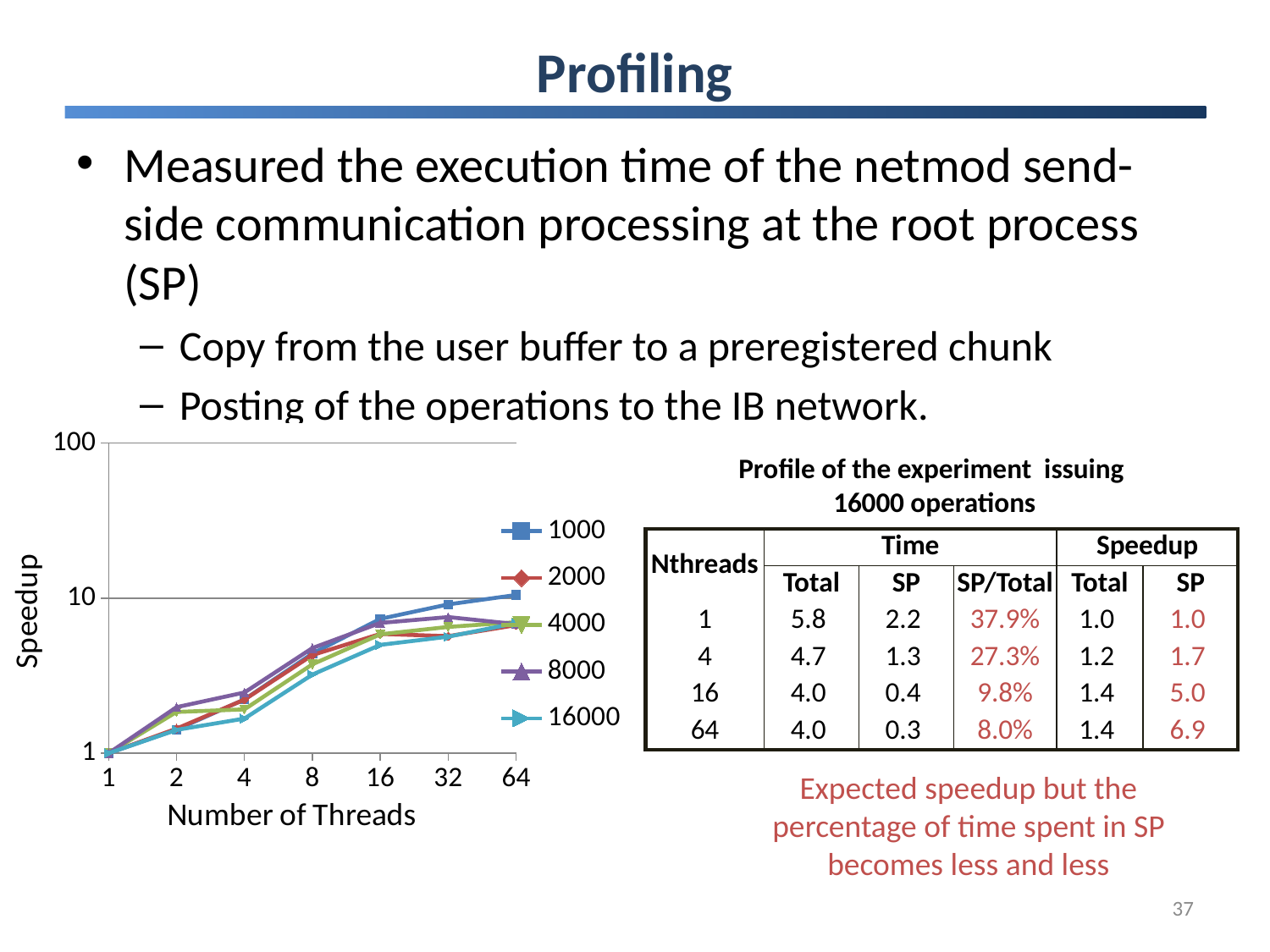
Is the speedup for the 8000 series at 16 threads greater or less than 10? less What is the label of the chart's y axis? Speedup Which series has the highest speedup at 64 threads? 1000 What is the label of the chart's x axis? Number of Threads Is the speedup for the 16000 series at 8 threads greater or less than 1? greater What is the speedup for the 16000 series at 1 thread? 1 At 64 threads, which series has the larger speedup, 1000 or 16000? 1000 What kind of chart is shown on the slide? line chart How many thread counts are plotted along the x axis of the chart? 7 Does the speedup for the 1000 series rise or fall as the number of threads increases? rise At 4 threads, which series has the larger speedup, 8000 or 16000? 8000 How many series does the chart's legend list? 5